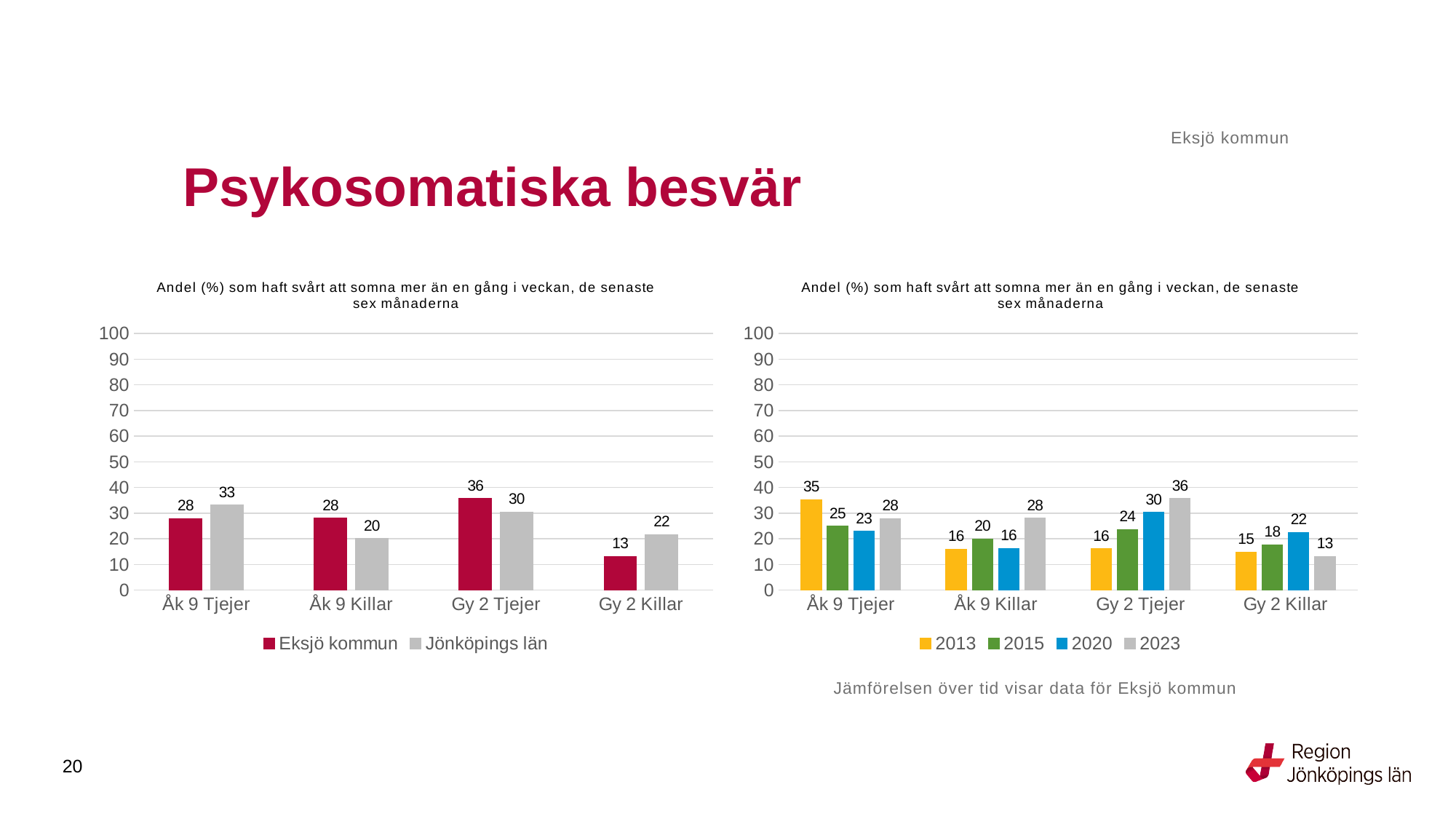
In the right chart, what is the value for 2013 for Åk 9 Tjejer? 35 In the left chart, what is the value for Jönköpings län for Åk 9 Killar? 20 In the left chart, which category has the lowest value for Eksjö kommun? Gy 2 Killar How many series does the legend of the left chart list? 2 In the left chart, what is the value for Eksjö kommun for Gy 2 Tjejer? 36 In the right chart, what is the value for 2020 for Gy 2 Killar? 22 In the right chart, what is the difference between 2023 and 2013 for Gy 2 Tjejer? 20 What kind of chart is the right chart? Bar chart In the left chart, what is the difference between Jönköpings län and Eksjö kommun for Gy 2 Killar? 9 In the right chart, which year has the highest value for Gy 2 Tjejer? 2023 In the left chart, which is larger for Åk 9 Tjejer: Eksjö kommun or Jönköpings län? Jönköpings län How many series does the legend of the right chart list? 4